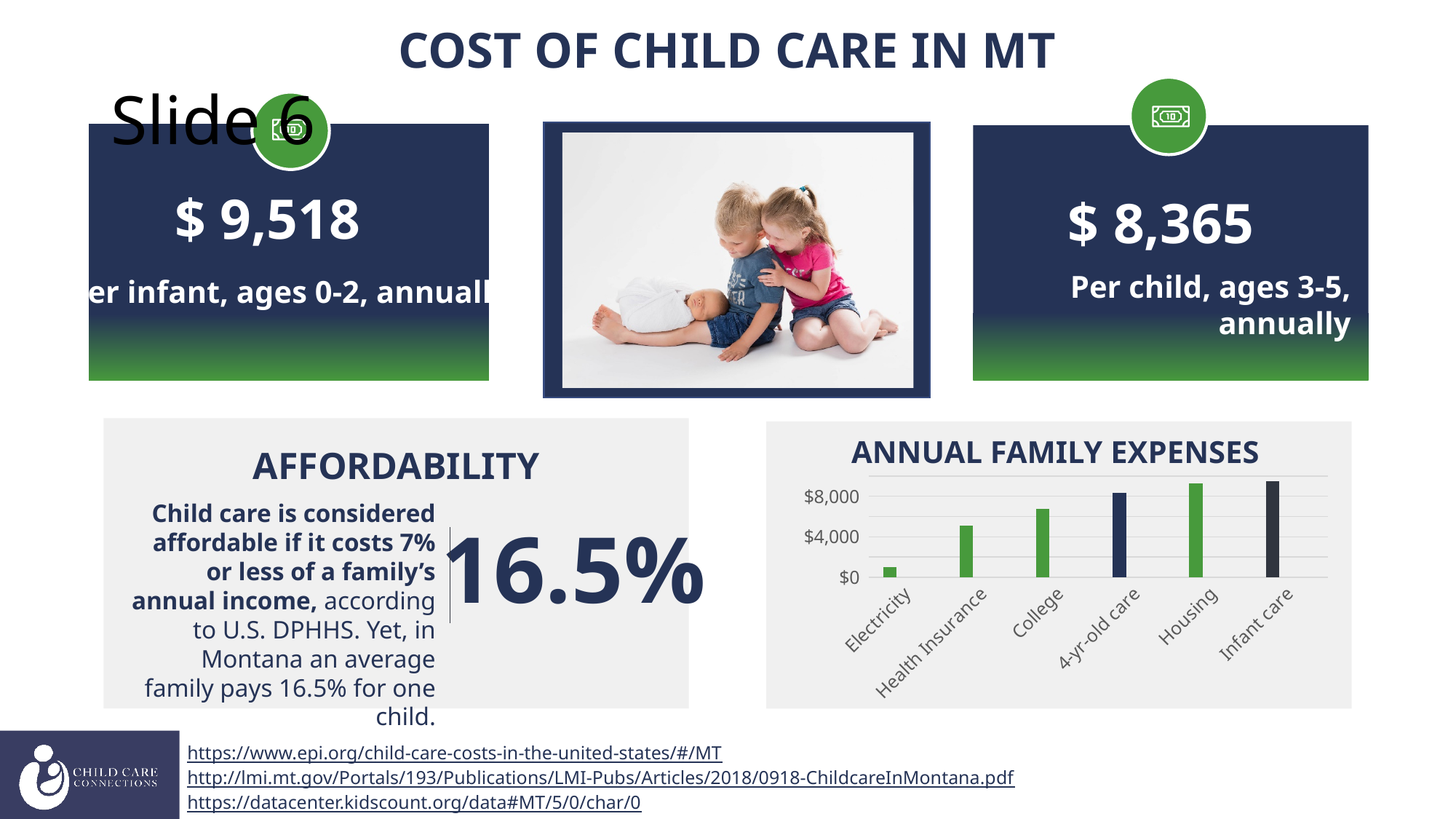
Do the values in the "Annual Family Expenses" chart rise or fall from left to right? rise What is the title of the bar chart on the slide? ANNUAL FAMILY EXPENSES In the "Annual Family Expenses" chart, is the value for Health Insurance greater or less than $4,000? greater In the "Annual Family Expenses" chart, is the value for Housing greater or less than $8,000? greater What kind of chart is the "Annual Family Expenses" chart? bar chart Which category has the lowest value in the "Annual Family Expenses" chart? Electricity In the "Annual Family Expenses" chart, is the value for College greater or less than $8,000? less In the "Annual Family Expenses" chart, which is larger: College or Health Insurance? College In the "Annual Family Expenses" chart, which is larger: Electricity or 4-yr-old care? 4-yr-old care How many expense categories are shown in the "Annual Family Expenses" chart? 6